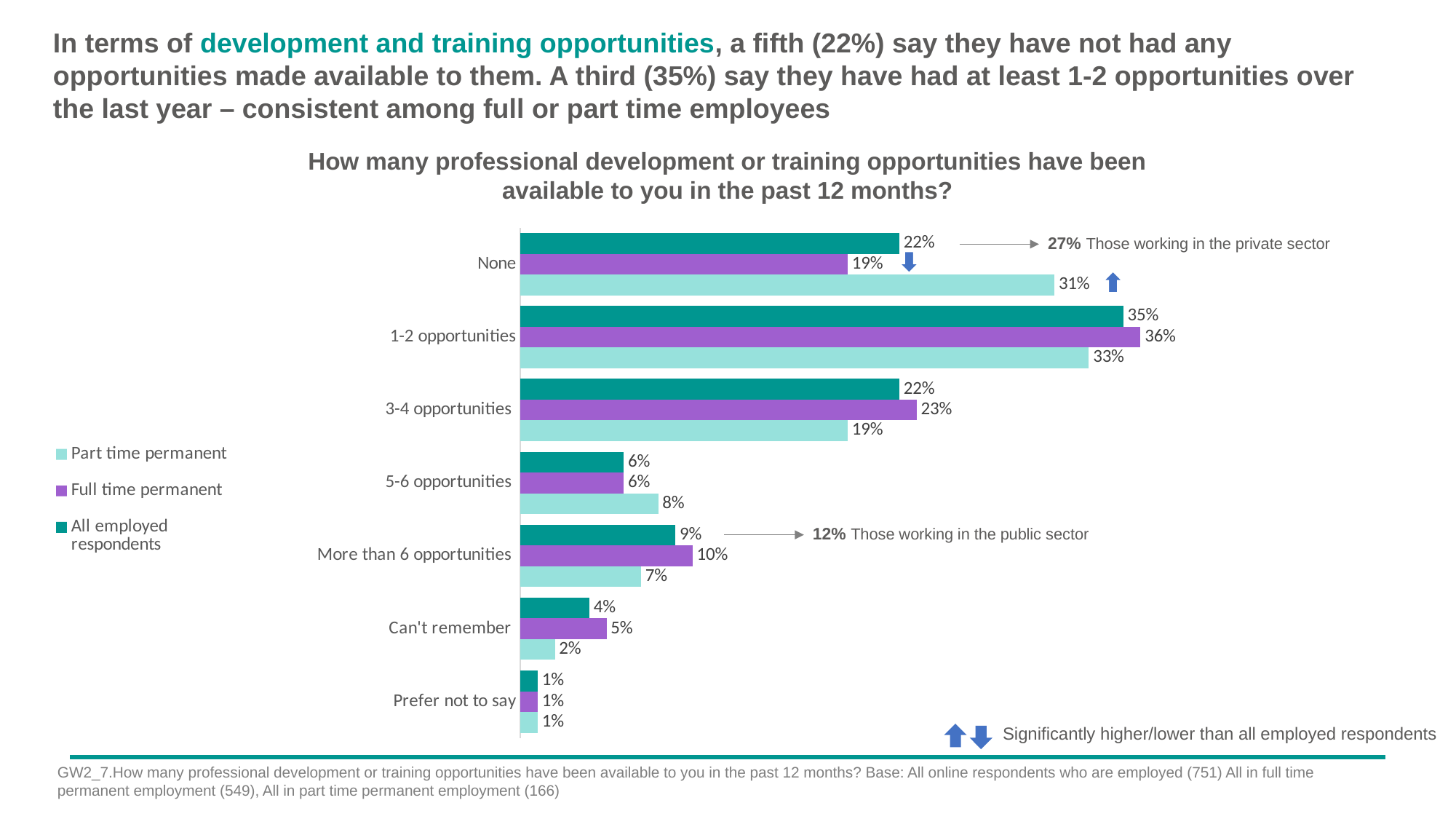
How many series does the legend list? 3 What percentage of full time permanent employees said they had more than 6 opportunities? 10% Which category has the highest value for full time permanent employees? 1-2 opportunities What percentage of all employed respondents said they had no development or training opportunities in the past 12 months? 22% What type of chart is shown on the slide? Bar chart What percentage of part time permanent employees said they had 1-2 opportunities? 33% Which category has the lowest value for part time permanent employees? Prefer not to say What is the difference between the part time permanent and full time permanent values for 'None'? 12 percentage points For 3-4 opportunities, which is larger: the full time permanent value or the part time permanent value? Full time permanent According to the annotation, what percentage of those working in the private sector said they had no opportunities? 27% How many response categories are shown on the chart? 7 Which series is shown in purple in the legend? Full time permanent